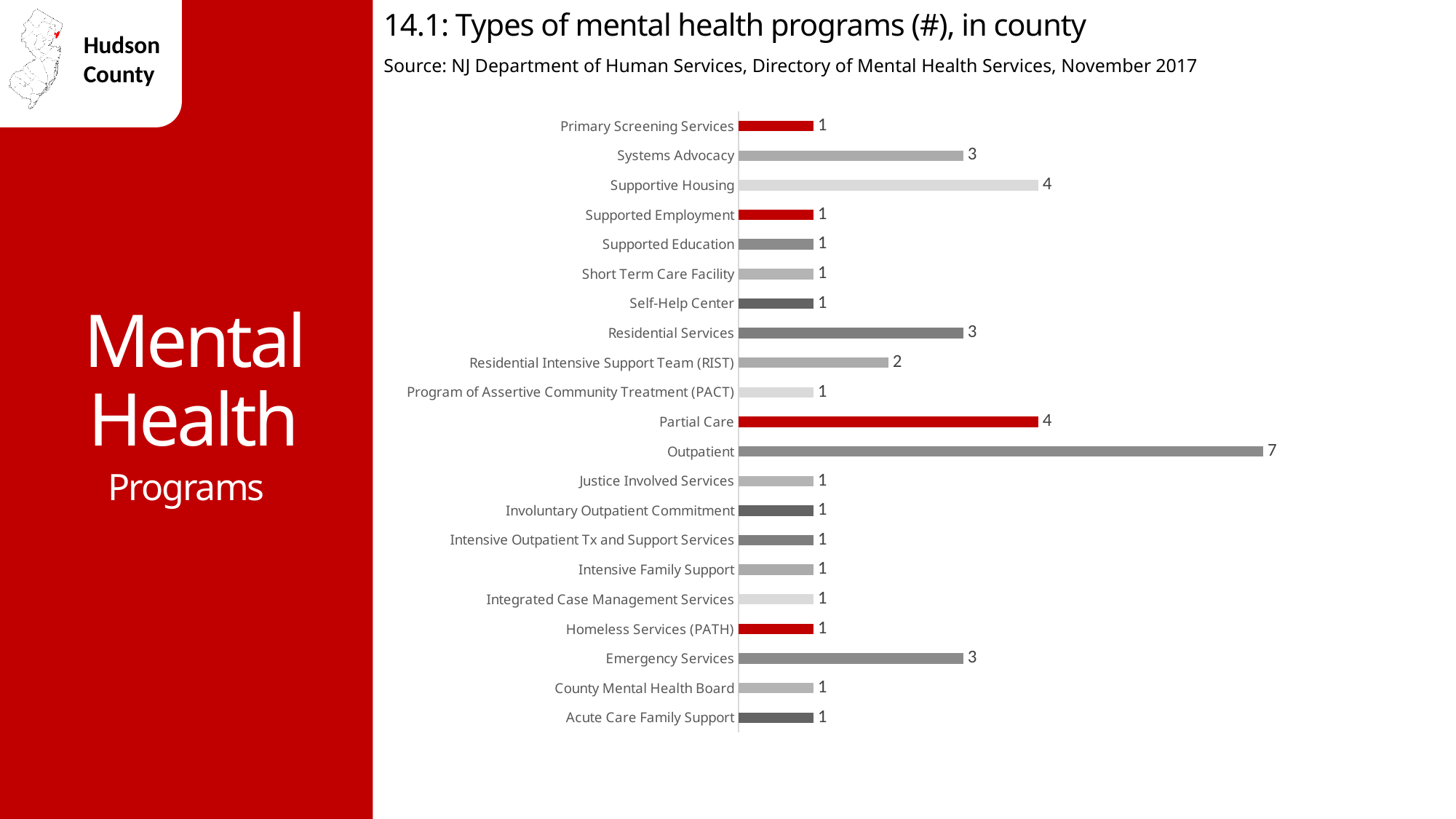
Which type of mental health program has the highest count in the chart? Outpatient What is the difference between the values for Systems Advocacy and Residential Intensive Support Team (RIST)? 1 What kind of chart is shown on the slide? Bar chart Which has a larger value, Residential Services or Supportive Housing? Supportive Housing How many types of mental health programs are listed in the chart? 21 How many Supportive Housing programs are shown in the chart? 4 What is the source cited for the chart? NJ Department of Human Services, Directory of Mental Health Services, November 2017 What is the number of Outpatient programs shown in the chart? 7 What is the difference between the number of Outpatient programs and the number of Partial Care programs? 3 What is the value for Emergency Services? 3 What value is shown for Residential Intensive Support Team (RIST)? 2 Which has a larger value, Partial Care or Homeless Services (PATH)? Partial Care